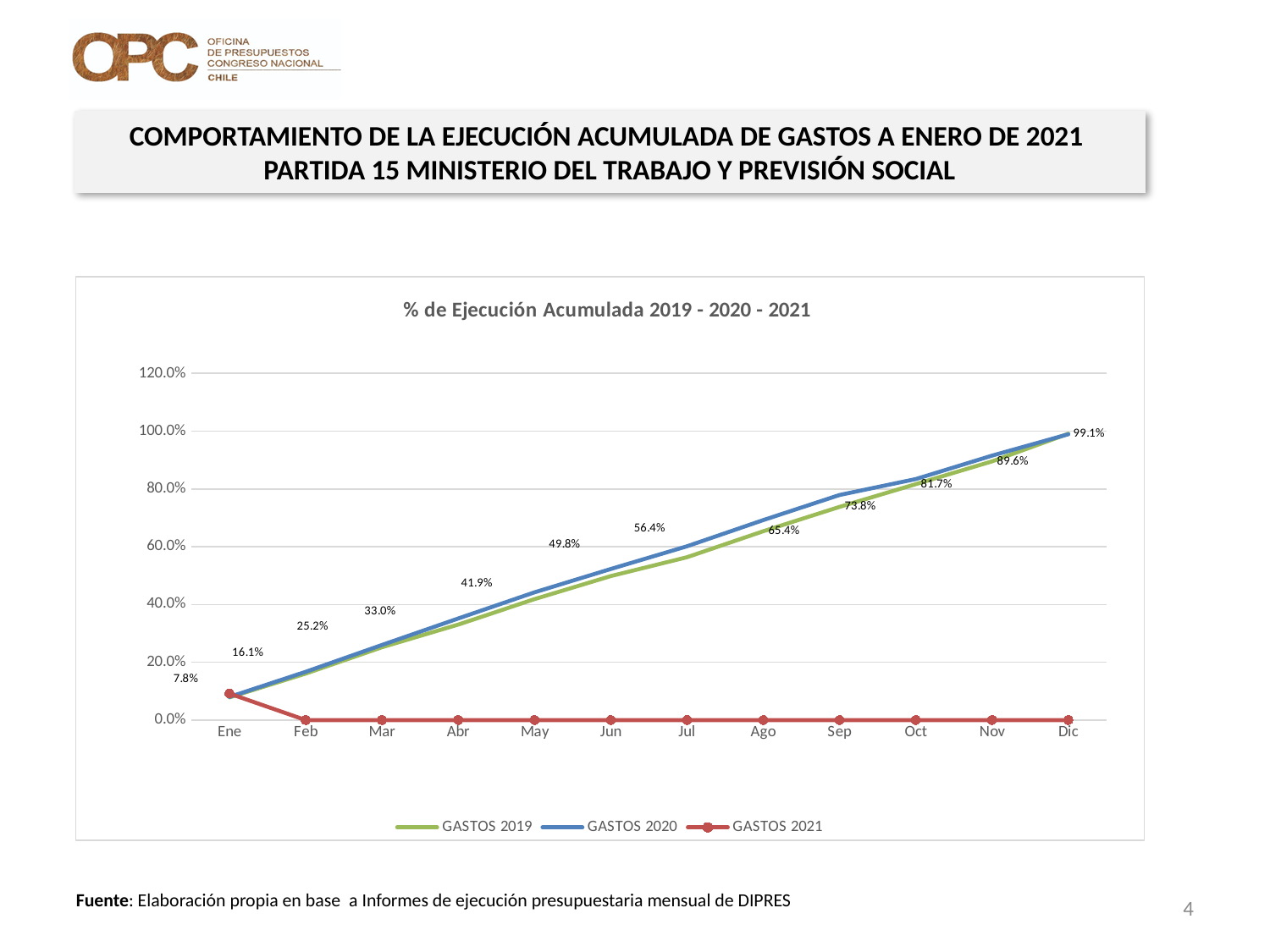
Which is larger at Feb: GASTOS 2020 or GASTOS 2021? GASTOS 2020 What is the title of the chart? % de Ejecución Acumulada 2019 - 2020 - 2021 How many series does the chart legend list? 3 Which month has the lowest labeled value on the chart? Ene Is the value for GASTOS 2020 at Sep greater or less than 60%? greater What is the difference between the data labels shown at Dic (99.1%) and Nov (89.6%)? 9.5 percentage points How many months are shown along the x axis of the chart? 12 What data label is shown at Dic on the chart? 99.1% What type of chart is shown on the slide? line chart What data label is shown at Jun on the chart? 49.8% What data label is shown at Ene on the chart? 7.8% Do the labeled values on the chart rise or fall from Ene to Dic? rise